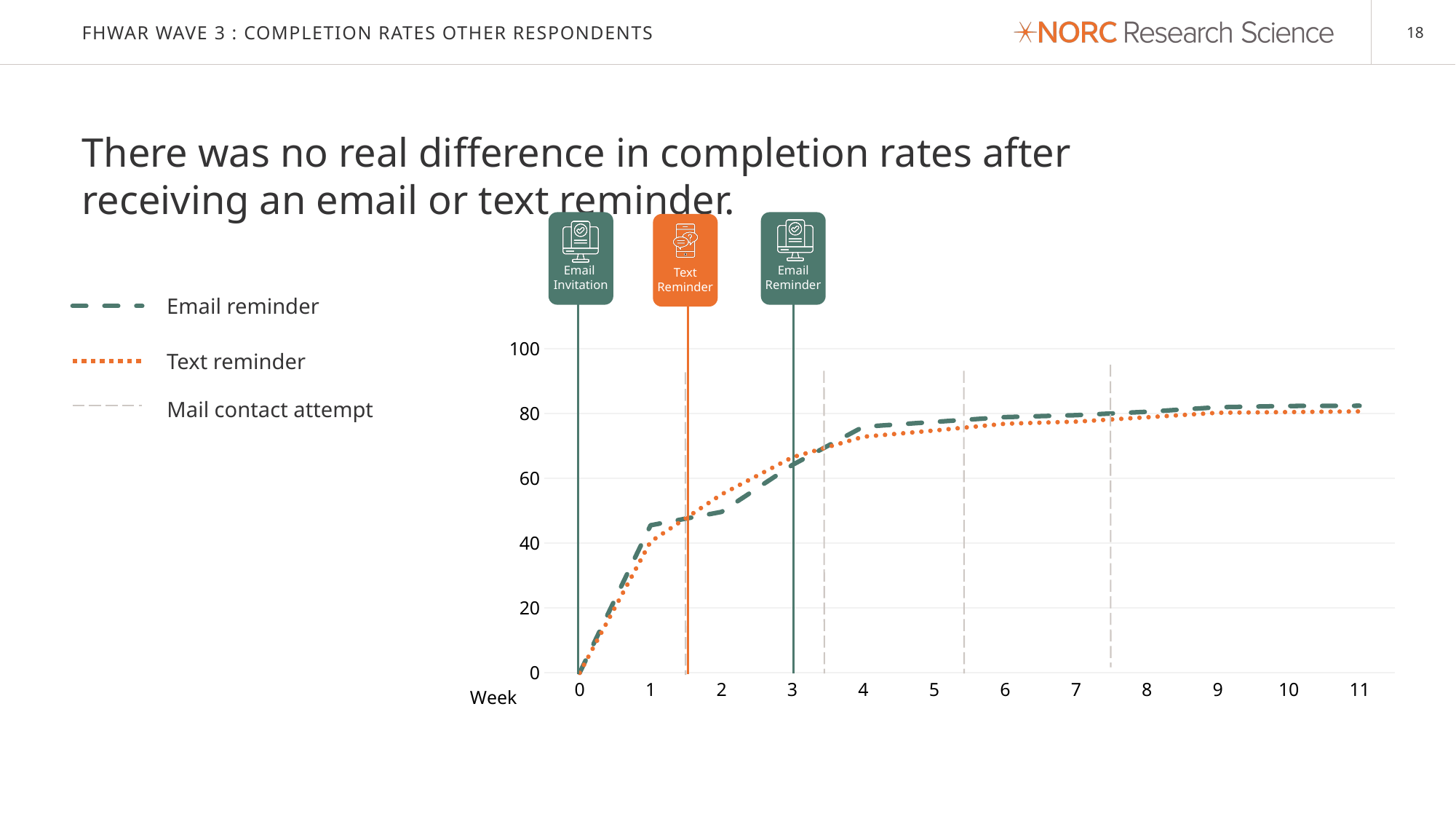
How many week points are marked on the x axis? 12 How many entries does the chart legend list? 3 Is the value for the Text reminder line at week 5 greater or less than 60? greater Is the value for the Email reminder line at week 1 greater or less than 60? less What is the label of the x axis? Week Do the completion rates rise or fall as the weeks increase? Rise What kind of chart is shown on the slide? Line chart Is the value for the Email reminder line at week 4 greater or less than 60? greater How many vertical dashed Mail contact attempt lines are drawn on the chart? 4 What are the two data series plotted as lines in the chart? Email reminder and Text reminder What is the value of the Email reminder line at week 0? 0